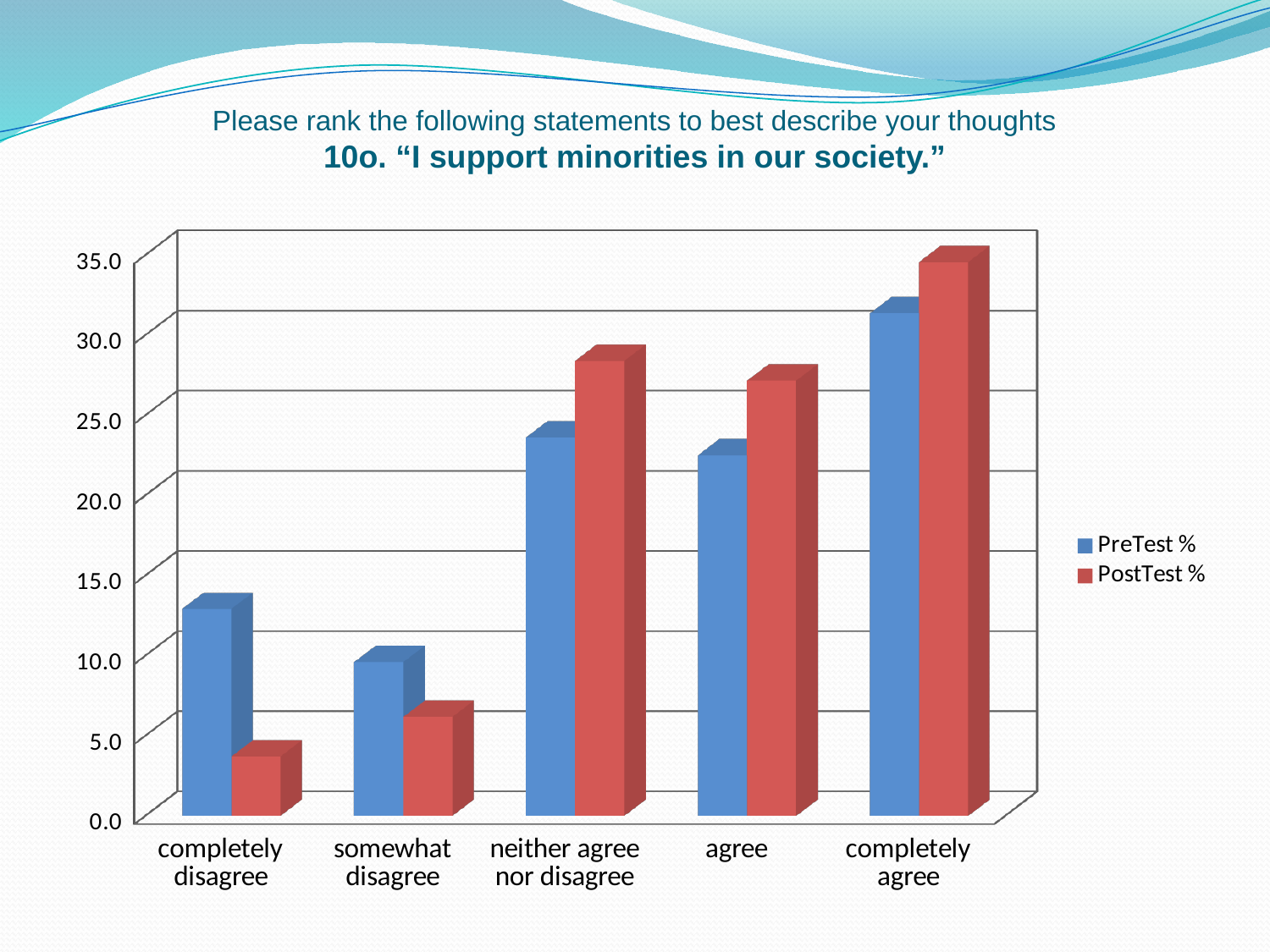
How many series does the legend list? 2 Which category has the lowest PreTest % value? somewhat disagree For 'completely disagree', which is larger: PreTest % or PostTest %? PreTest % For 'neither agree nor disagree', which is larger: PreTest % or PostTest %? PostTest % Is the PostTest % value for 'neither agree nor disagree' greater or less than 25.0? greater Which category has the highest PreTest % value? completely agree Which category has the lowest PostTest % value? completely disagree How many response categories are shown on the x axis? 5 What are the two series names shown in the legend? PreTest % and PostTest % Is the PreTest % value for 'completely agree' greater or less than 30.0? greater What kind of chart is shown on the slide? bar chart Is the PostTest % value for 'completely disagree' greater or less than 5.0? less